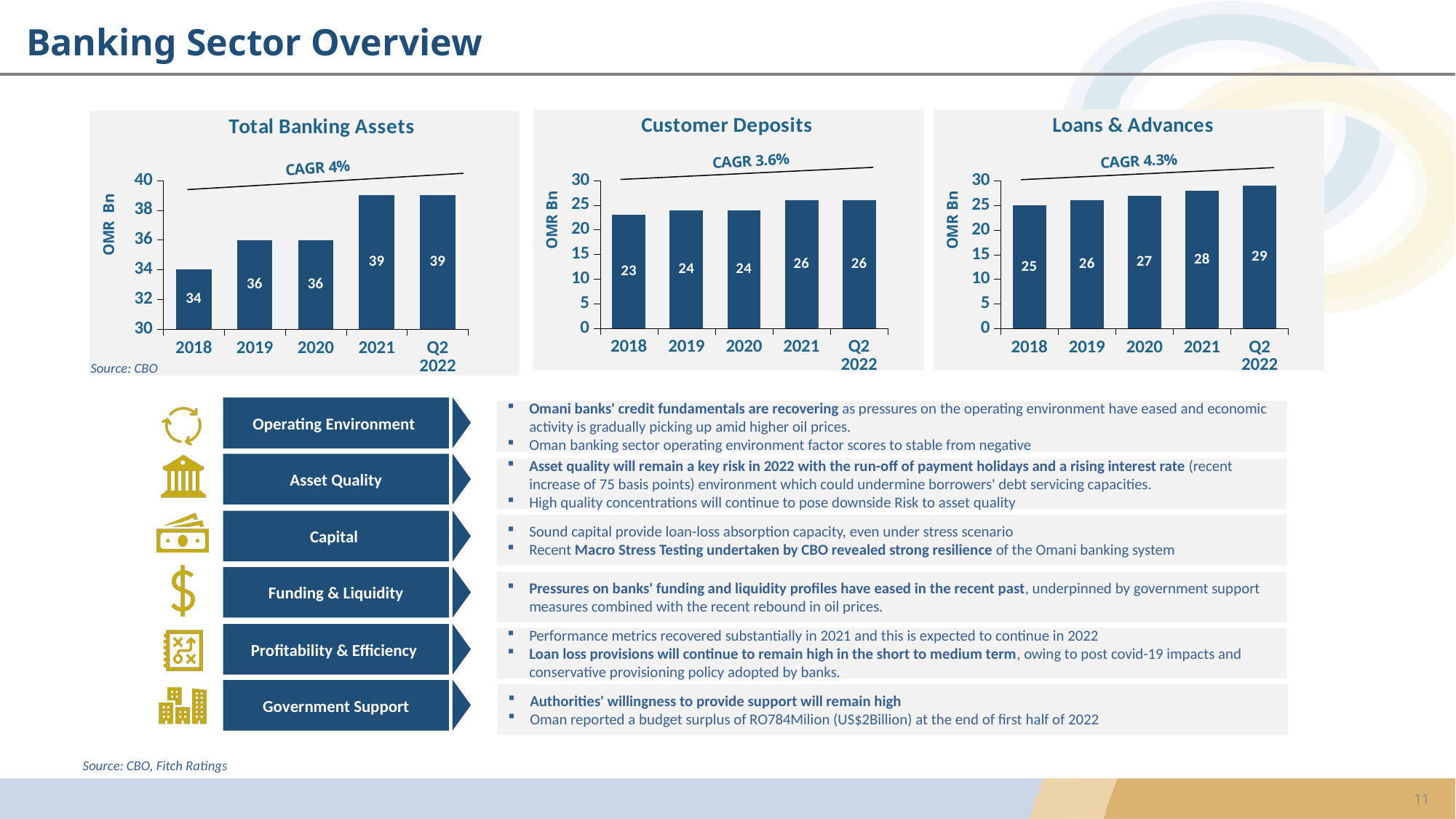
In the Loans & Advances chart, do the values rise or fall from 2018 to Q2 2022? rise In the Loans & Advances chart, which period has the highest value? Q2 2022 In the Total Banking Assets chart, what is the difference between the 2021 value and the 2018 value? 5 In the Loans & Advances chart, which is larger, the value for 2019 or the value for 2021? 2021 In the Loans & Advances chart, what is the value for 2020? 27 What type of chart is the Customer Deposits chart? bar chart In the Total Banking Assets chart, what is the value for 2018? 34 What CAGR is shown on the Loans & Advances chart? CAGR 4.3% In the Total Banking Assets chart, which year has the lowest value? 2018 In the Customer Deposits chart, what is the value for Q2 2022? 26 In the Customer Deposits chart, how many bars are plotted? 5 In the Customer Deposits chart, is the value for 2018 greater or less than 20? greater